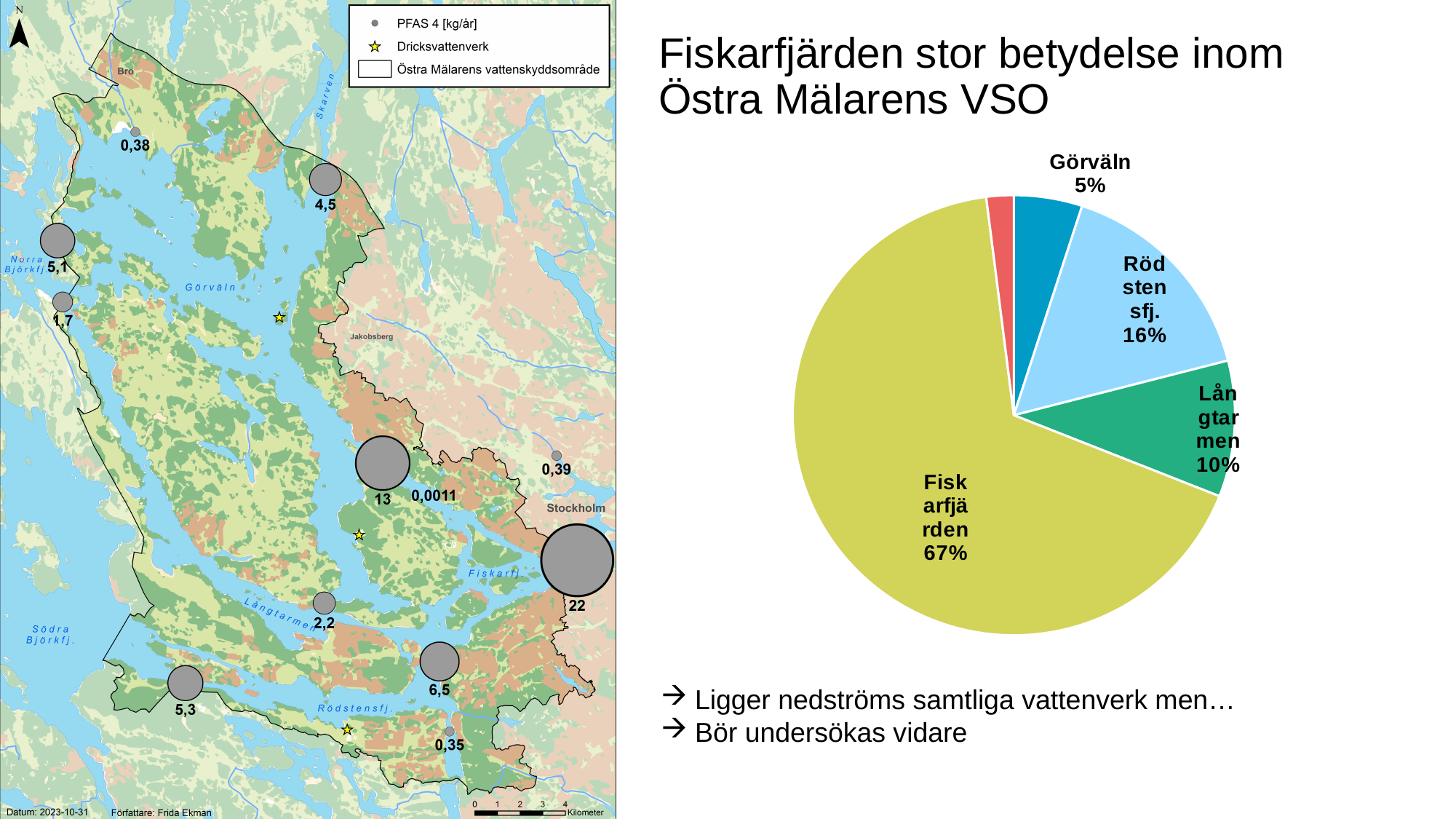
What is the title of the slide above the pie chart? Fiskarfjärden stor betydelse inom Östra Mälarens VSO In the pie chart, what share does Görväln have? 5% What kind of chart is shown on the right side of the slide? pie chart On the map on the left, what PFAS 4 value is labelled at Stockholm? 22 In the pie chart, which of the labelled slices is the smallest? Görväln In the pie chart, what share does Långtarmen have? 10% In the pie chart, which slice is the largest? Fiskarfjärden In the pie chart, what share does Rödstensfj. have? 16% In the pie chart, what share does Fiskarfjärden have? 67% In the pie chart, how many percentage points larger is Fiskarfjärden's share than Rödstensfj.'s share? 51 percentage points In the pie chart, which has the larger share, Långtarmen or Görväln? Långtarmen In the pie chart, what is the difference between the shares of Rödstensfj. and Långtarmen? 6 percentage points